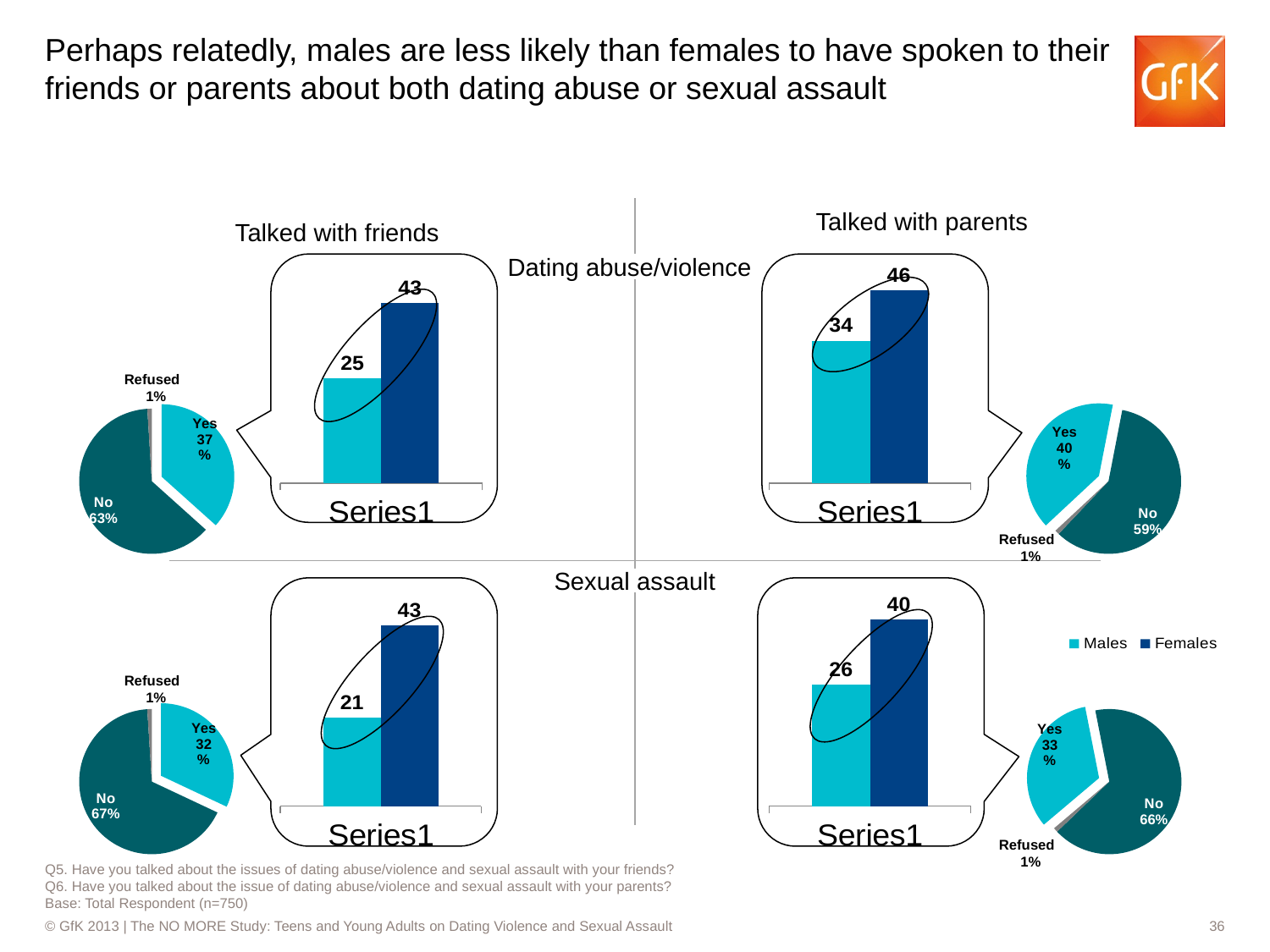
In the 'Talked with friends' bar chart for sexual assault (bottom left), what is the difference between the Females and Males values? 22 In the 'Talked with parents' bar chart for sexual assault (bottom right), which is larger, Males or Females? Females In the top-right pie chart (talked with parents about dating abuse/violence), what share of respondents answered 'Yes'? 40% In the 'Talked with friends' bar chart for dating abuse/violence (top left), what is the value for Females? 43 In the 'Talked with parents' bar chart for dating abuse/violence (top right), what is the difference between the Females and Males values? 12 In the bottom-right pie chart (talked with parents about sexual assault), which slice is the largest? No In the bottom-left pie chart (talked with friends about sexual assault), what share of respondents answered 'Yes'? 32% How many series does the legend on the slide list? 2 In the bottom-right pie chart (talked with parents about sexual assault), which slice is the smallest? Refused In the top-left pie chart (talked with friends about dating abuse/violence), what share of respondents answered 'No'? 63% In the 'Talked with parents' bar chart for dating abuse/violence (top right), what is the value for Males? 34 What kind of chart is used to show the Males and Females comparison in each callout? Bar chart